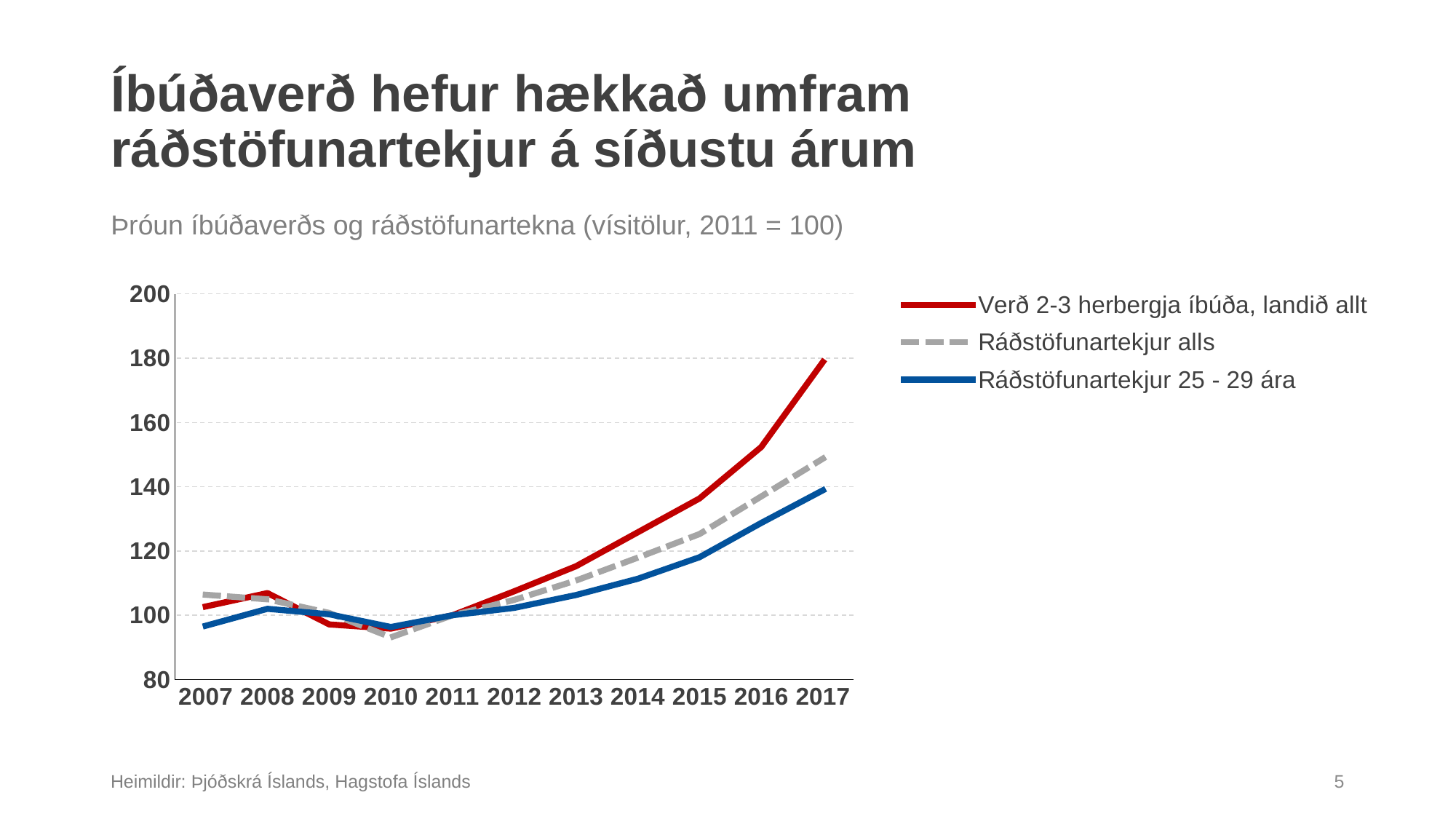
Which is larger in 2017: 'Ráðstöfunartekjur alls' or 'Ráðstöfunartekjur 25 - 29 ára'? Ráðstöfunartekjur alls Which series is drawn with a dashed grey line? Ráðstöfunartekjur alls Which series has the highest value in 2017? Verð 2-3 herbergja íbúða, landið allt How many series does the legend list? 3 Is the value for 'Ráðstöfunartekjur alls' in 2010 greater or less than 100? less Is the value for 'Ráðstöfunartekjur 25 - 29 ára' in 2007 greater or less than 100? less How many years are shown on the x axis? 11 What kind of chart is shown on the slide? line chart In which year does the series 'Ráðstöfunartekjur alls' reach its lowest value? 2010 Do the values of 'Verð 2-3 herbergja íbúða, landið allt' rise or fall from 2011 to 2017? rise What is the value of all three series in 2011? 100 Is the value for 'Verð 2-3 herbergja íbúða, landið allt' in 2017 greater or less than 160? greater